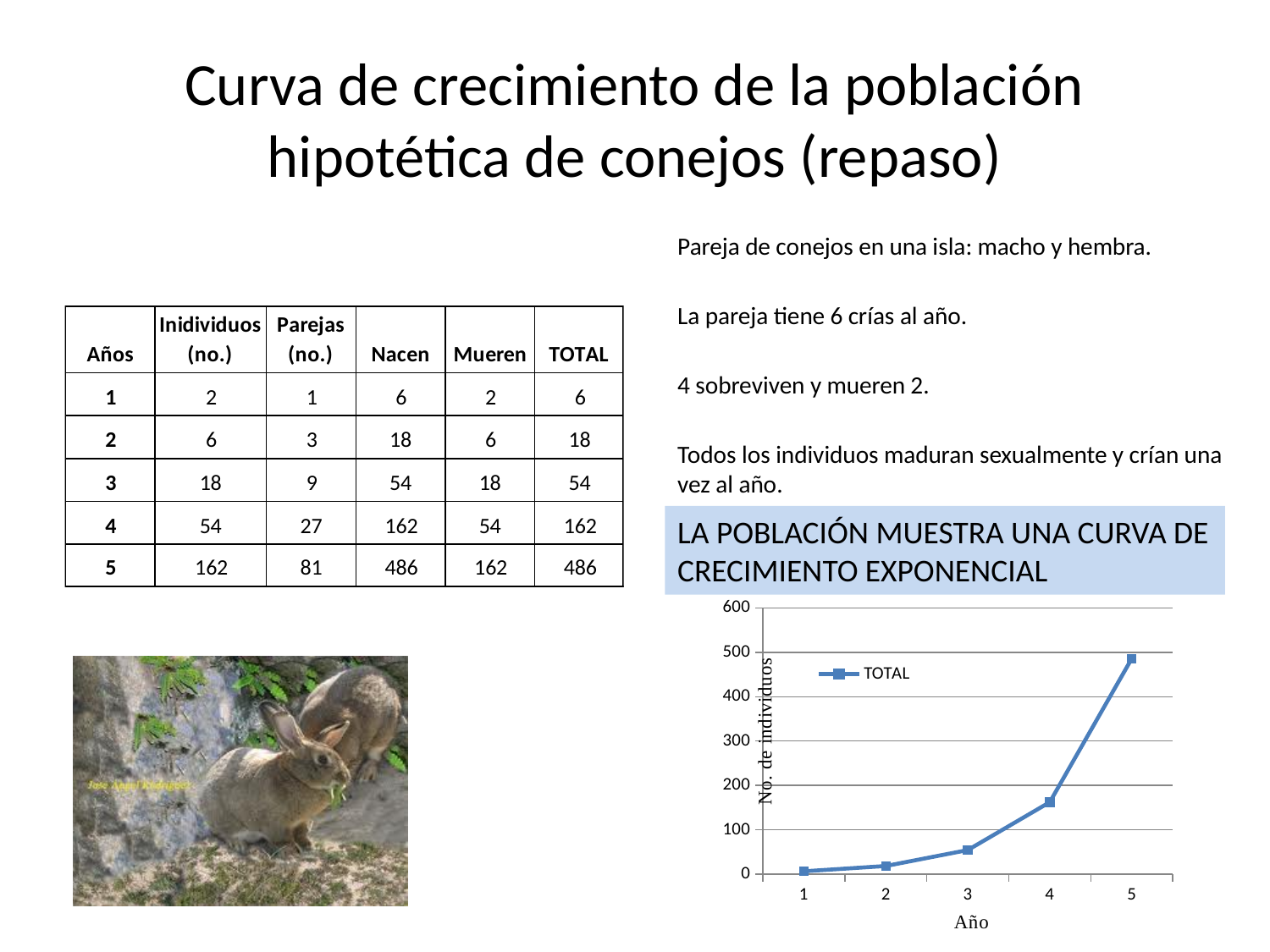
What is the title of the chart's x axis? Año Is the value for year 5 on the chart greater or less than 400? greater Which year has the highest value on the chart? 5 Is the value for year 4 on the chart greater or less than 200? less Which year has the lowest value on the chart? 1 Is the value for year 3 on the chart greater or less than 100? less How many series does the chart's legend list? 1 Do the values on the chart rise or fall as the year increases? rise What kind of chart is shown on the slide? line chart How many data points are plotted on the chart? 5 Which is larger on the chart, the value for year 4 or the value for year 3? year 4 What is the name of the series shown in the chart's legend? TOTAL